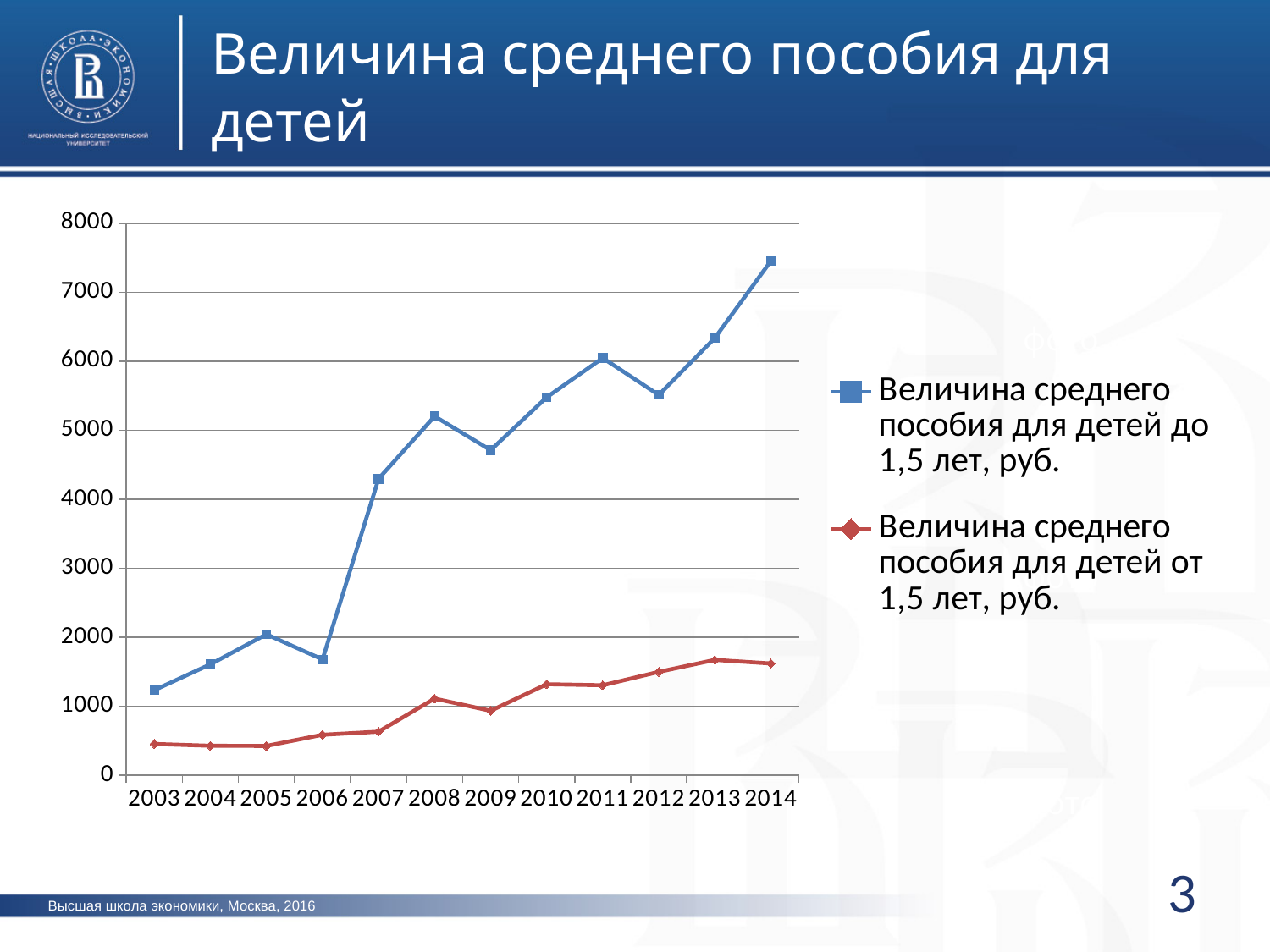
Is the 2014 value for 'Величина среднего пособия для детей от 1,5 лет, руб.' greater or less than 2000? less Is the 2007 value for 'Величина среднего пособия для детей до 1,5 лет, руб.' greater or less than 4000? greater What colour is the line for 'Величина среднего пособия для детей от 1,5 лет, руб.'? red How many series does the legend list? 2 How many years are plotted along the x axis? 12 What kind of chart is shown on the slide? line chart In which year is the value for 'Величина среднего пособия для детей до 1,5 лет, руб.' lowest? 2003 For 'Величина среднего пособия для детей до 1,5 лет, руб.', which year has the larger value, 2011 or 2012? 2011 Overall, does the value for 'Величина среднего пособия для детей до 1,5 лет, руб.' rise or fall from 2003 to 2014? rise Is the 2014 value for 'Величина среднего пособия для детей до 1,5 лет, руб.' greater or less than 7000? greater In which year is the value for 'Величина среднего пособия для детей до 1,5 лет, руб.' highest? 2014